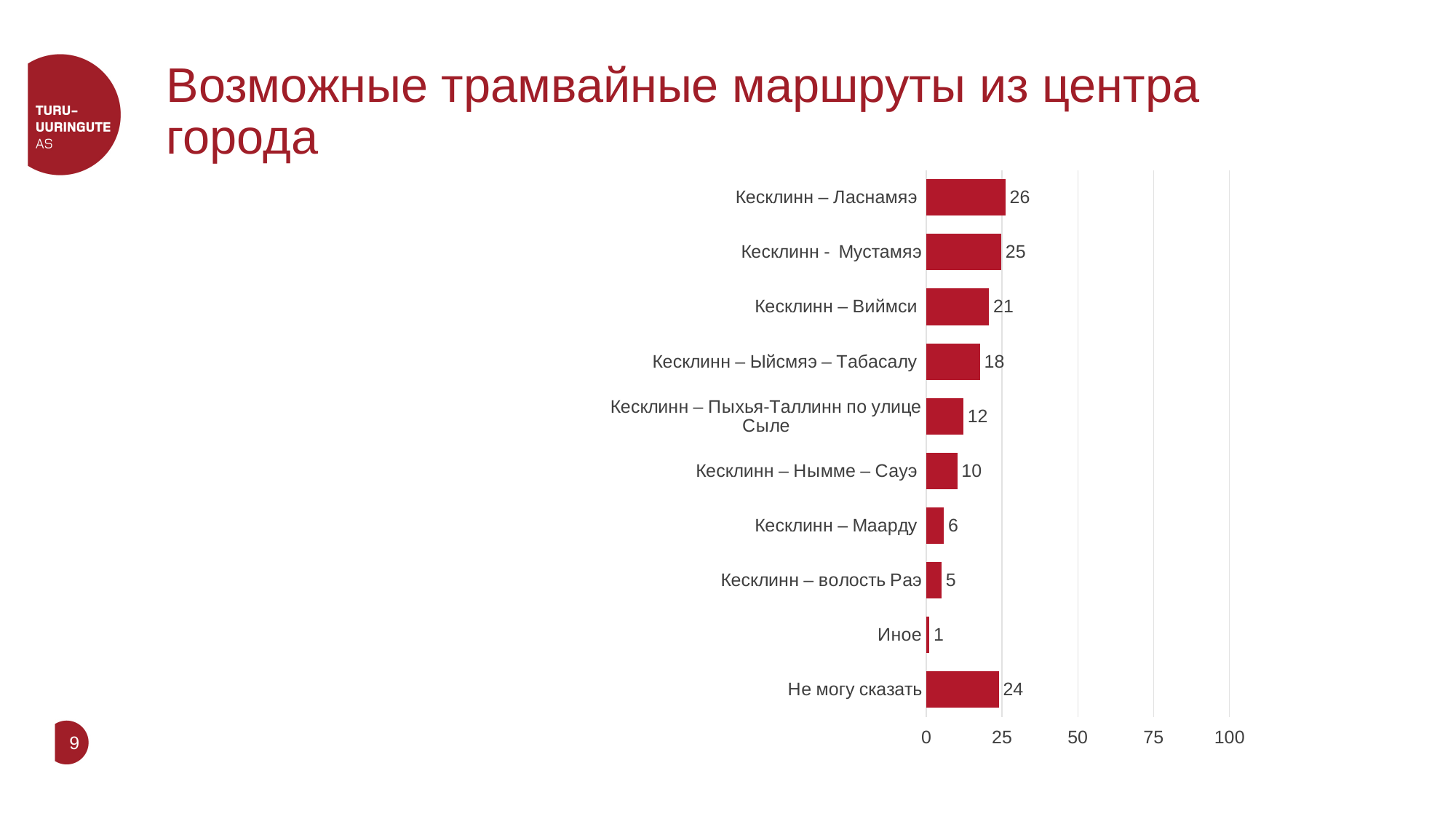
What is the value for Кесклинн – Ласнамяэ? 26 Which category has the lowest value? Иное How many categories are shown in the chart? 10 Is the value for Кесклинн - Мустамяэ greater or less than 50? less Which is larger, the value for Кесклинн – Маарду or the value for Кесклинн – волость Раэ? Кесклинн – Маарду What is the difference between the values for Кесклинн – Виймси and Кесклинн – Нымме – Сауэ? 11 What is the value for Кесклинн – Ыйсмяэ – Табасалу? 18 Which category has the highest value? Кесклинн – Ласнамяэ What is the title of the slide? Возможные трамвайные маршруты из центра города What kind of chart is shown on the slide? bar chart What is the value for Не могу сказать? 24 What is the value for Кесклинн – Пыхья-Таллинн по улице Сыле? 12